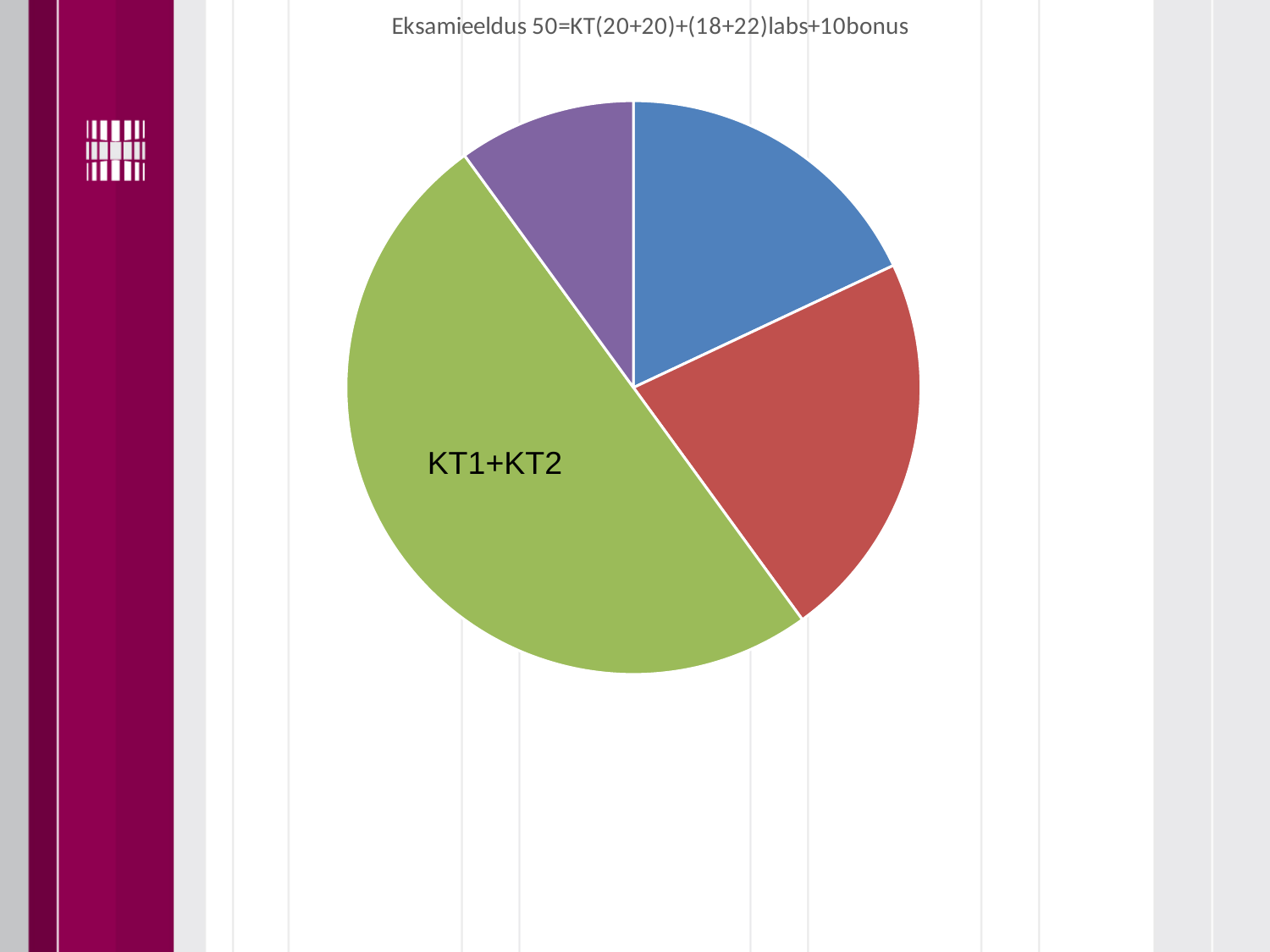
What kind of chart is shown on the slide? pie chart What colour is the smallest slice of the pie chart? purple What is the title of the pie chart? Eksamieeldus 50=KT(20+20)+(18+22)labs+10bonus Which slice of the pie chart carries a text label, and what does it say? the green slice, KT1+KT2 Which slice is larger, the blue slice or the purple slice? the blue slice How many slices does the pie chart have? 4 What colour is the largest slice of the pie chart? green Which slice is larger, the red slice or the blue slice? the red slice Which slice of the pie chart is the largest? KT1+KT2 Which slice is larger, the KT1+KT2 slice or the purple slice? KT1+KT2